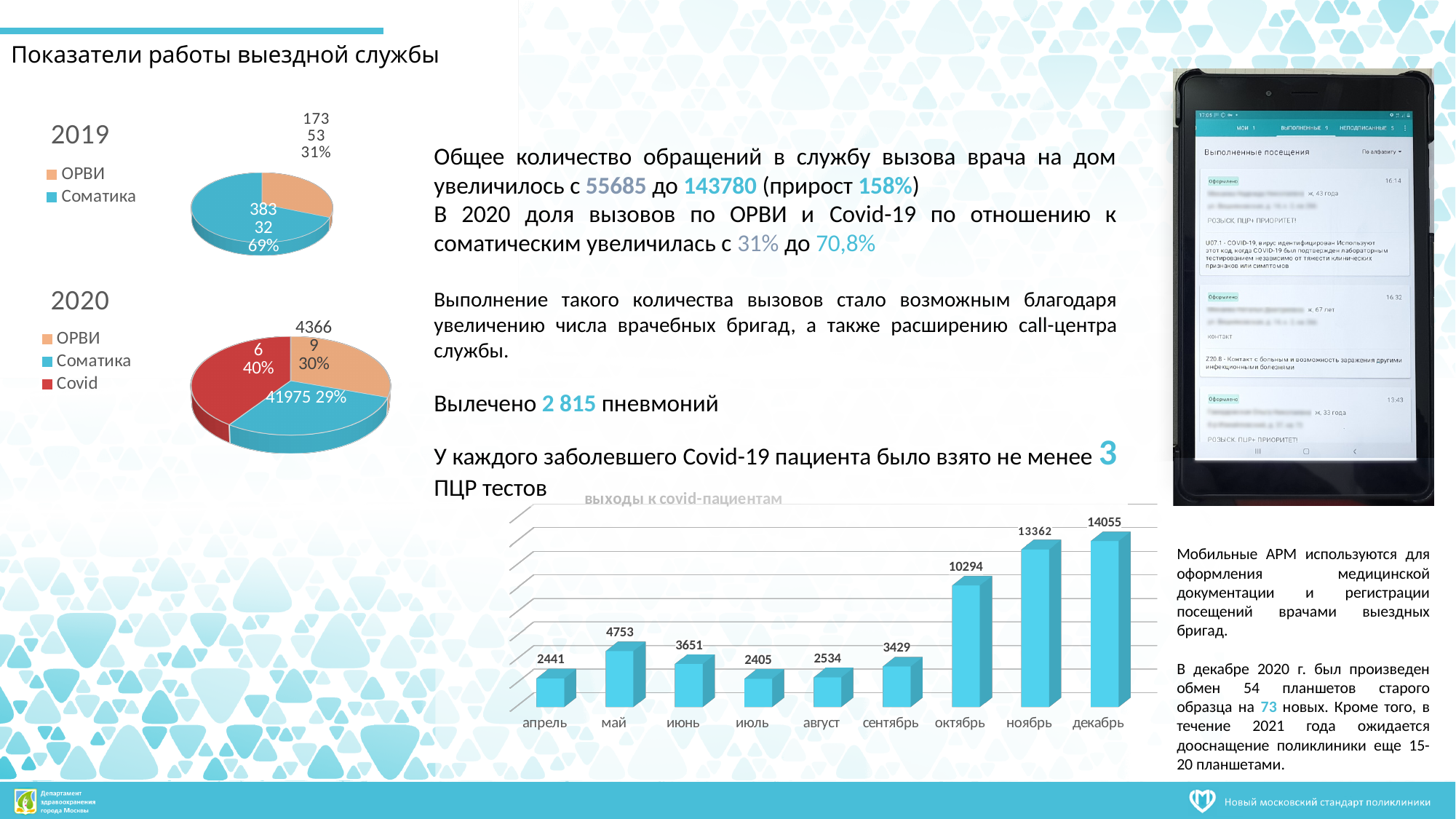
How many entries does the legend of the 2020 pie chart list? 3 In the 2020 pie chart, what share does Covid have? 40% In the bar chart 'выходы к covid-пациентам', what is the difference between the values for ноябрь and октябрь? 3068 In the bar chart 'выходы к covid-пациентам', do the values rise or fall from сентябрь to декабрь? rise In the bar chart 'выходы к covid-пациентам', which month has the lowest value? июль What kind of chart is 'выходы к covid-пациентам'? bar chart In the 2019 pie chart, what share does Соматика have? 69% In the bar chart 'выходы к covid-пациентам', which month has the highest value? декабрь In the bar chart 'выходы к covid-пациентам', which is larger: the value for июнь or the value for сентябрь? июнь In the bar chart 'выходы к covid-пациентам', what is the value for май? 4753 In the bar chart 'выходы к covid-пациентам', what is the value for декабрь? 14055 How many months are shown in the bar chart 'выходы к covid-пациентам'? 9